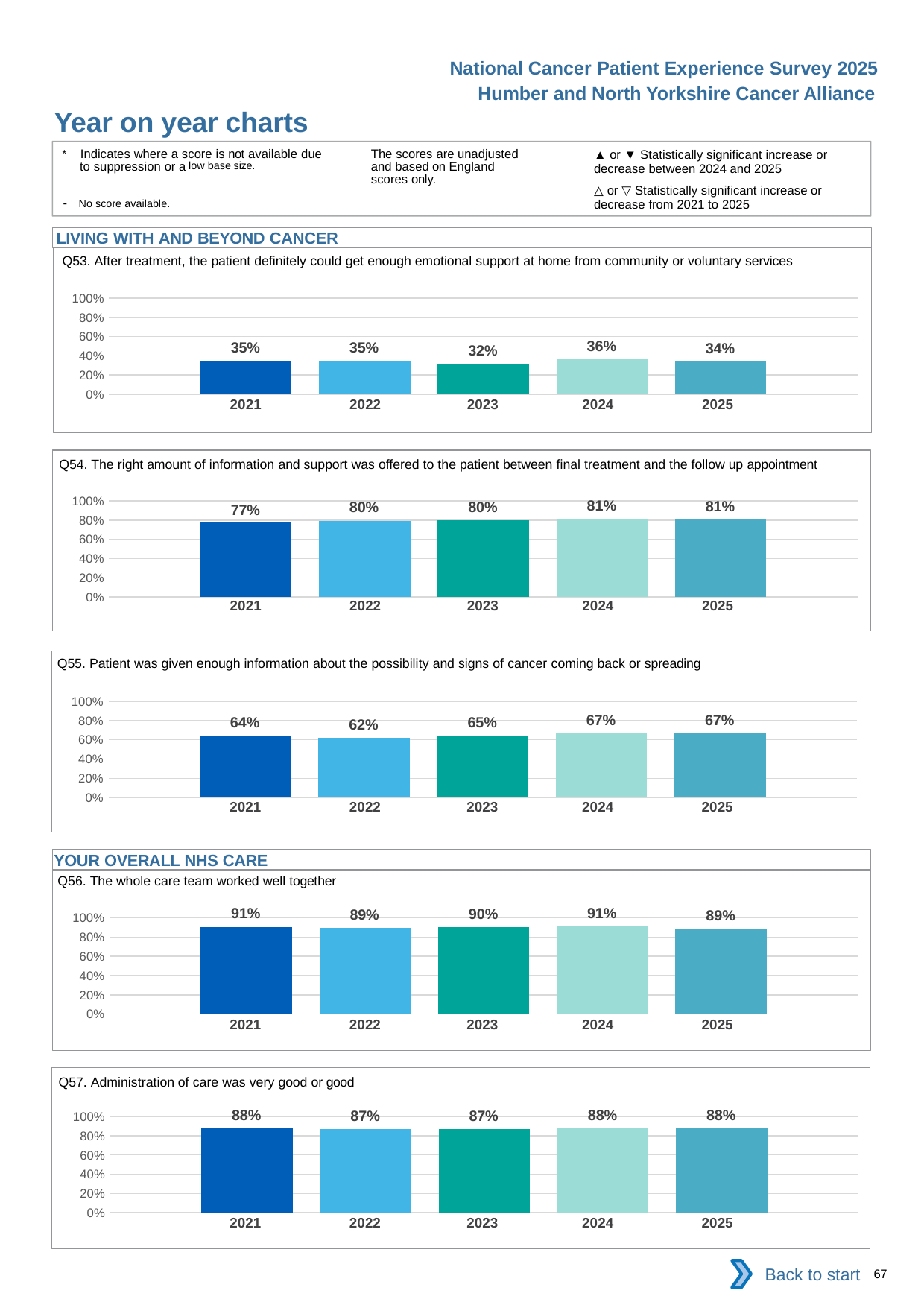
In the Q53 chart, which year has the lowest value? 2023 In the Q56 chart, what is the value for 2025? 89% In the Q55 chart, what is the value for 2023? 65% In the Q57 chart, what is the difference between the 2021 value and the 2022 value? 1% In the Q53 chart, is the value for 2021 greater or less than 60%? less In the Q55 chart, which year has the lowest value? 2022 In the Q53 chart, what is the value for 2024? 36% How many years are shown on the x axis of the Q57 chart? 5 What kind of chart is the Q53 chart? Bar chart In the Q54 chart, what is the difference between the 2025 value and the 2021 value? 4% In the Q54 chart, what is the value for 2021? 77% In the Q56 chart, which is larger, the value for 2021 or the value for 2022? 2021